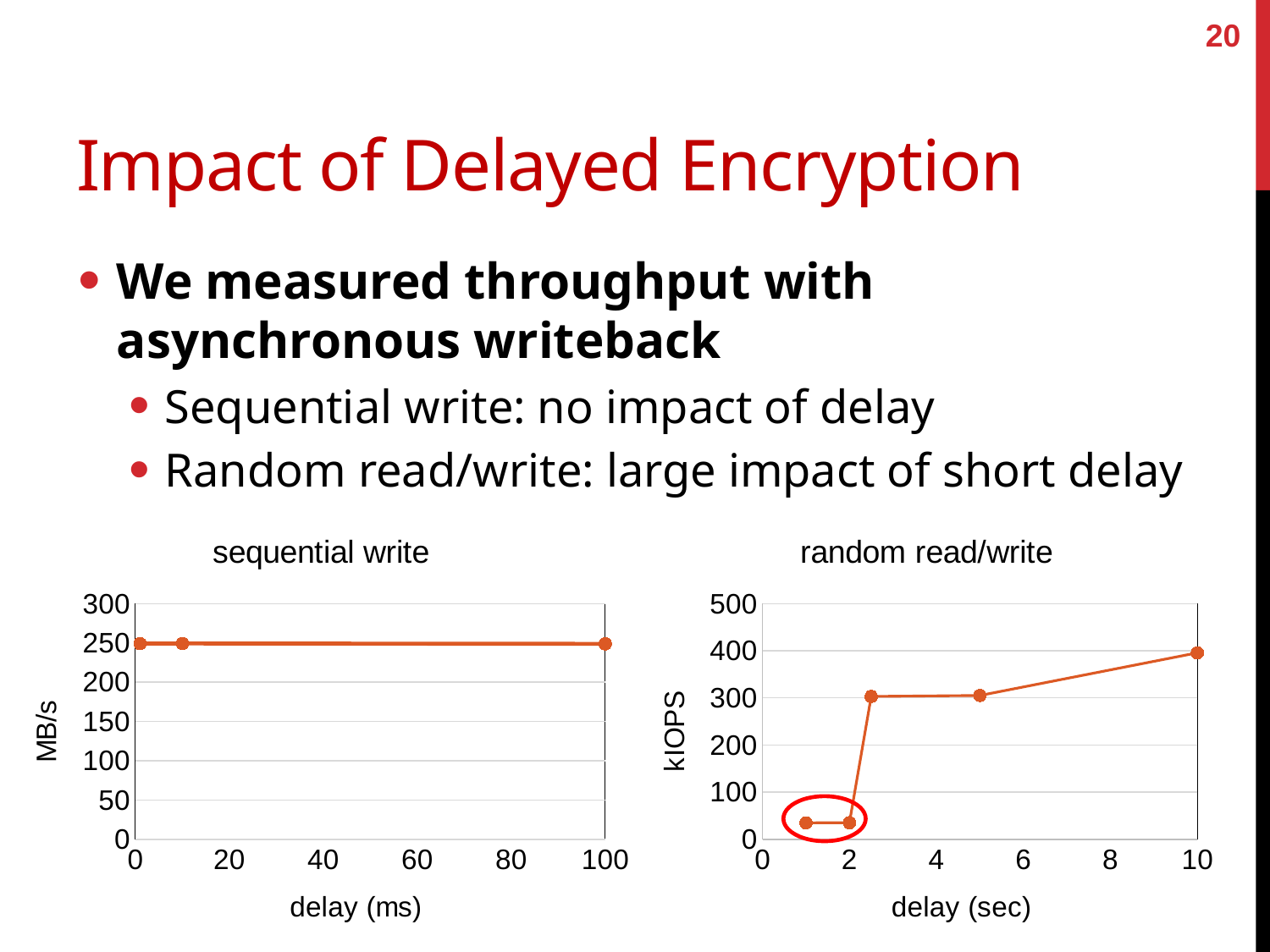
What is the x-axis label of the 'random read/write' chart? delay (sec) What is the y-axis label of the 'sequential write' chart? MB/s In the 'random read/write' chart, is the value at a delay of 5 sec greater or less than 200? greater What kind of chart is the 'sequential write' chart? line chart In the 'random read/write' chart, which is larger: the value at 2 sec or the value at 10 sec? 10 sec In the 'sequential write' chart, how many data points are plotted? 3 In the 'random read/write' chart, is the value at a delay of 1 sec greater or less than 100? less In the 'random read/write' chart, do the values generally rise or fall as delay increases? rise In the 'random read/write' chart, how many data points are plotted? 5 In the 'random read/write' chart, at which delay is the value highest? 10 sec In the 'sequential write' chart, is the value at a delay of 100 ms greater or less than 200? greater